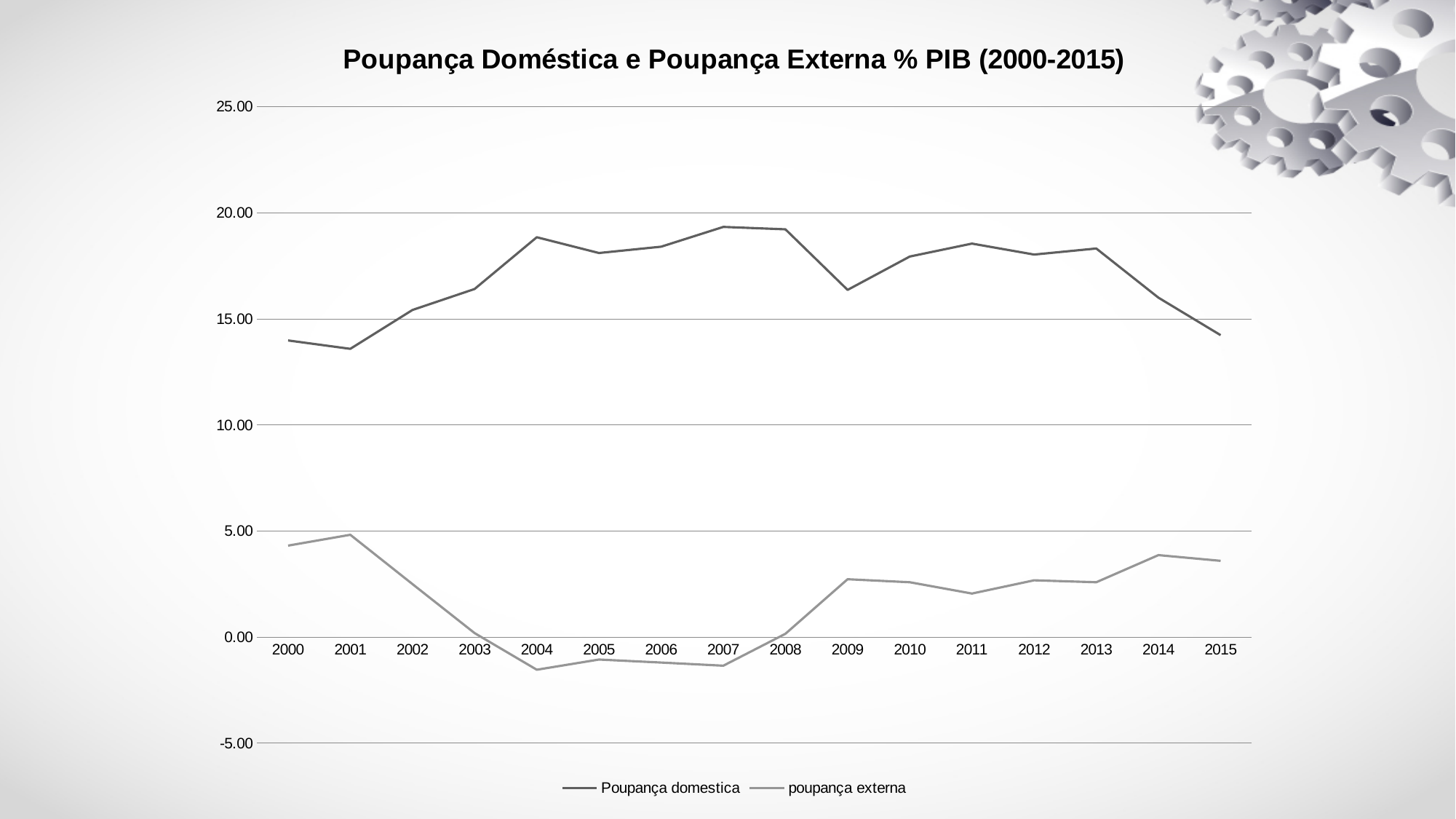
What kind of chart is shown on the slide? Line chart How many series does the legend list? 2 Is the value for Poupança domestica in 2007 greater or less than 15.00? greater Is the value for Poupança domestica in 2004 greater or less than 20.00? less Is the value for poupança externa in 2009 greater or less than 0.00? greater Does the Poupança domestica line rise or fall from 2013 to 2015? Fall What is the title of the chart? Poupança Doméstica e Poupança Externa % PIB (2000-2015) Which is larger for Poupança domestica: the value in 2004 or the value in 2009? 2004 How many years are plotted along the x axis? 16 Does the poupança externa line rise or fall from 2001 to 2004? Fall Which is larger for poupança externa: the value in 2001 or the value in 2011? 2001